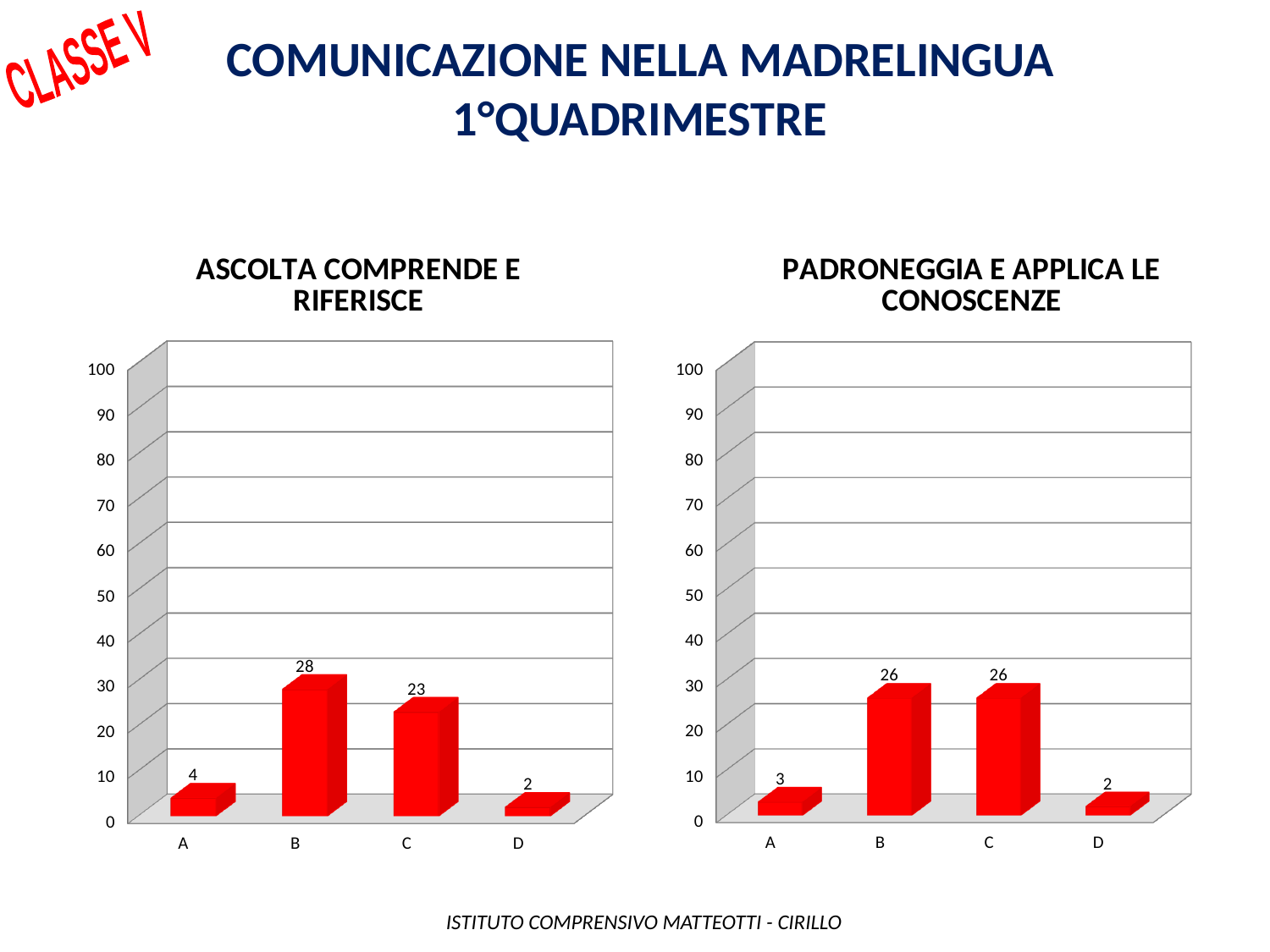
In the 'ASCOLTA COMPRENDE E RIFERISCE' chart, what is the difference between the values for B and C? 5 What kind of chart is the 'PADRONEGGIA E APPLICA LE CONOSCENZE' chart? Bar chart In the 'ASCOLTA COMPRENDE E RIFERISCE' chart, which category has the highest value? B In the 'ASCOLTA COMPRENDE E RIFERISCE' chart, which category has the lowest value? D In the 'PADRONEGGIA E APPLICA LE CONOSCENZE' chart, what is the difference between the values for B and A? 23 In the 'PADRONEGGIA E APPLICA LE CONOSCENZE' chart, what is the value for category C? 26 How many categories are shown in the 'ASCOLTA COMPRENDE E RIFERISCE' chart? 4 In the 'PADRONEGGIA E APPLICA LE CONOSCENZE' chart, which category has the lowest value? D In the 'ASCOLTA COMPRENDE E RIFERISCE' chart, what is the value for category D? 2 In the 'ASCOLTA COMPRENDE E RIFERISCE' chart, what is the value for category B? 28 In the 'PADRONEGGIA E APPLICA LE CONOSCENZE' chart, is the value for B greater or less than 20? greater In the 'PADRONEGGIA E APPLICA LE CONOSCENZE' chart, what is the value for category A? 3